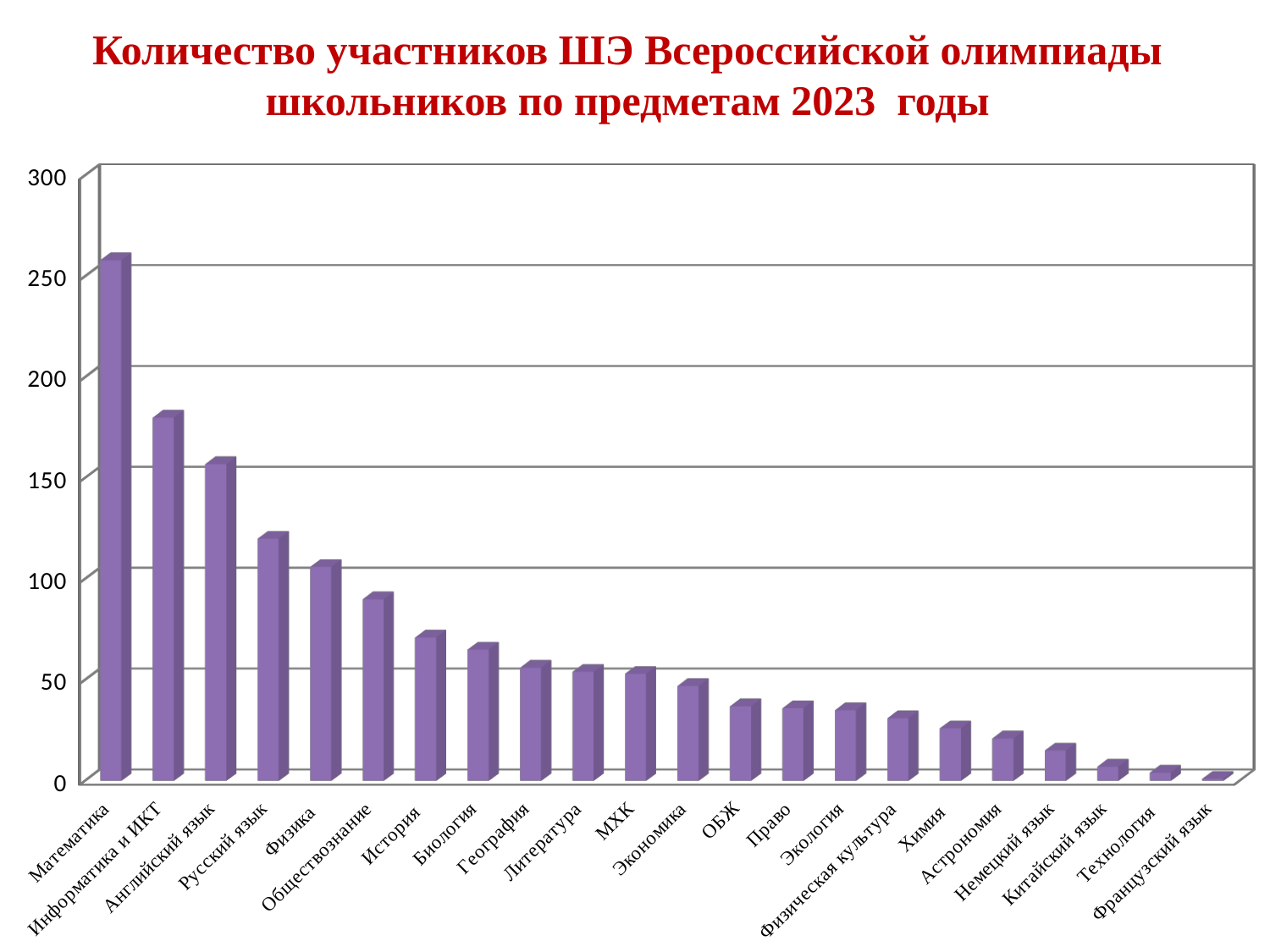
Is the value for Математика greater or less than 250? greater How many subjects (categories) are shown on the x axis? 22 Is the value for Обществознание greater or less than 100? less Which subject has the highest number of participants? Математика Which subject has the lowest number of participants? Французский язык Do the values rise or fall moving from left to right along the x axis? fall What is the title of the chart? Количество участников ШЭ Всероссийской олимпиады школьников по предметам 2023 годы Is the value for История greater or less than 50? greater What kind of chart is shown on the slide? bar chart Which has more participants, Английский язык or Русский язык? Английский язык